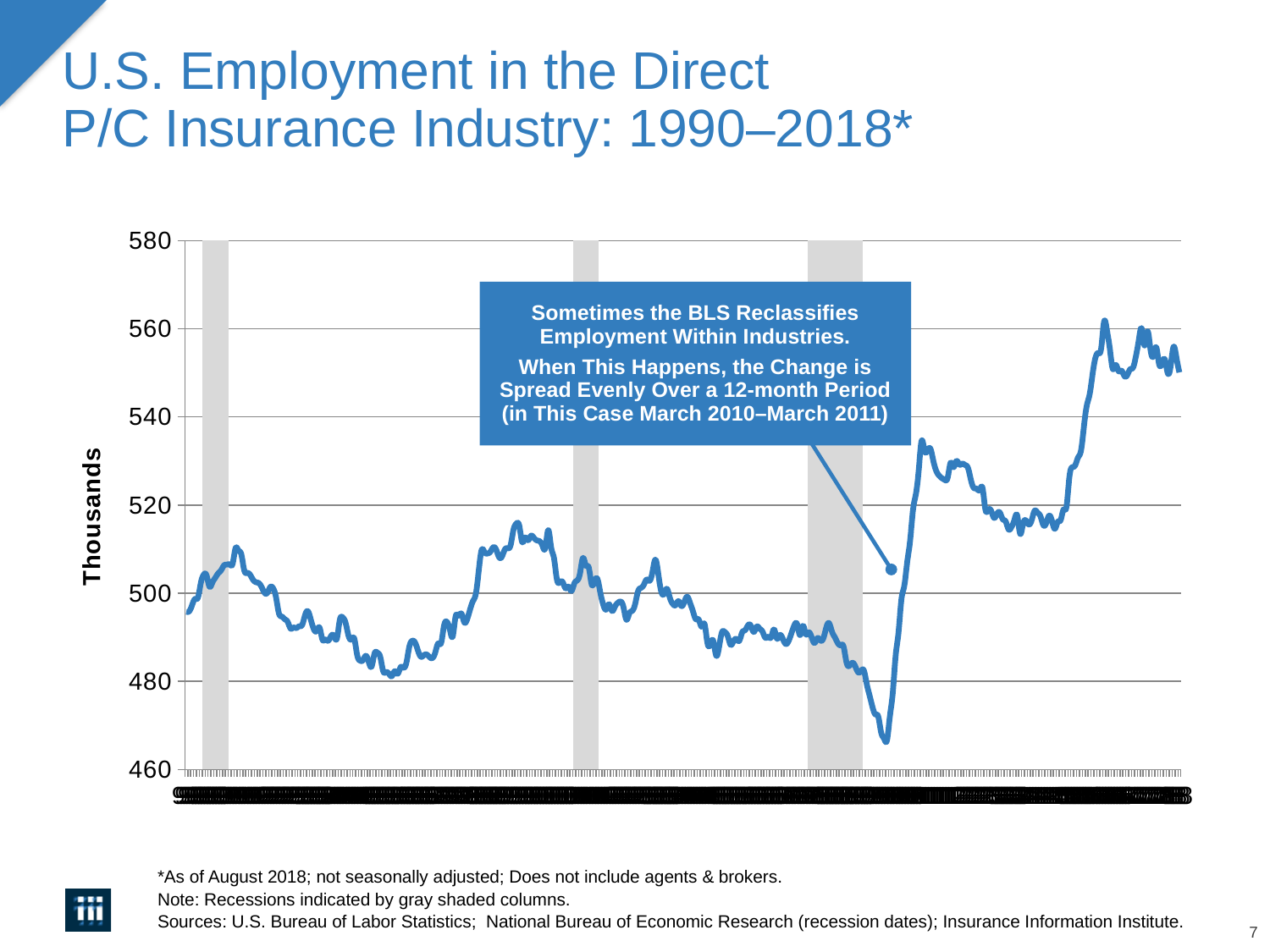
Is the value at the point marked by the callout arrow (the sharp dip before the steep rise) greater or less than 520? less Is the highest point of the line on the chart greater or less than 540? greater What is the lowest value shown on the vertical axis of the chart? 460 What kind of chart is shown on the slide? Line chart Is the value at the far right (end) of the line greater or less than 540? greater What is the highest value shown on the vertical axis of the chart? 580 What is the label on the vertical axis of the chart? Thousands How many gray shaded recession columns appear on the chart? 3 Comparing the start of the line to the end of the line, is the value at the end higher or lower? higher